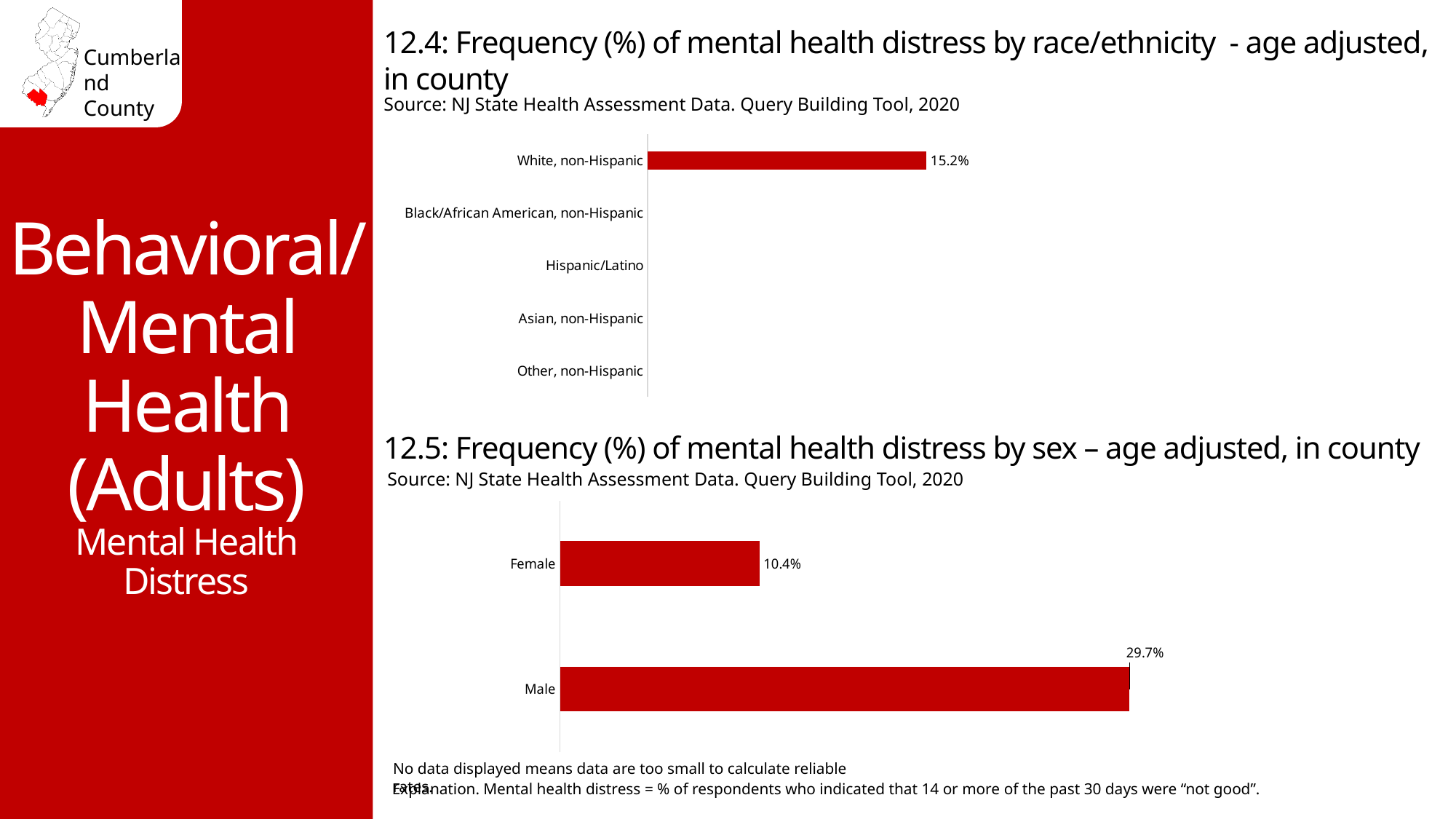
In chart 12.4 (mental health distress by race/ethnicity), which category is the only one with a bar displayed? White, non-Hispanic In chart 12.5 (mental health distress by sex), how many categories are shown? 2 In chart 12.5 (mental health distress by sex), which category has the lowest value? Female What is the source cited for chart 12.5 (mental health distress by sex)? NJ State Health Assessment Data. Query Building Tool, 2020 In chart 12.5 (mental health distress by sex), what is the difference between the Male and Female values? 19.3% In chart 12.5 (mental health distress by sex), is the value for Male larger or smaller than the value for Female? Larger In chart 12.5 (mental health distress by sex), what is the value for Male? 29.7% What kind of chart is chart 12.4 (mental health distress by race/ethnicity)? Bar chart In chart 12.4 (mental health distress by race/ethnicity), how many race/ethnicity categories are listed on the axis? 5 In chart 12.4 (mental health distress by race/ethnicity), what is the value for White, non-Hispanic? 15.2% In chart 12.5 (mental health distress by sex), what is the value for Female? 10.4% In chart 12.5 (mental health distress by sex), which category has the highest value? Male